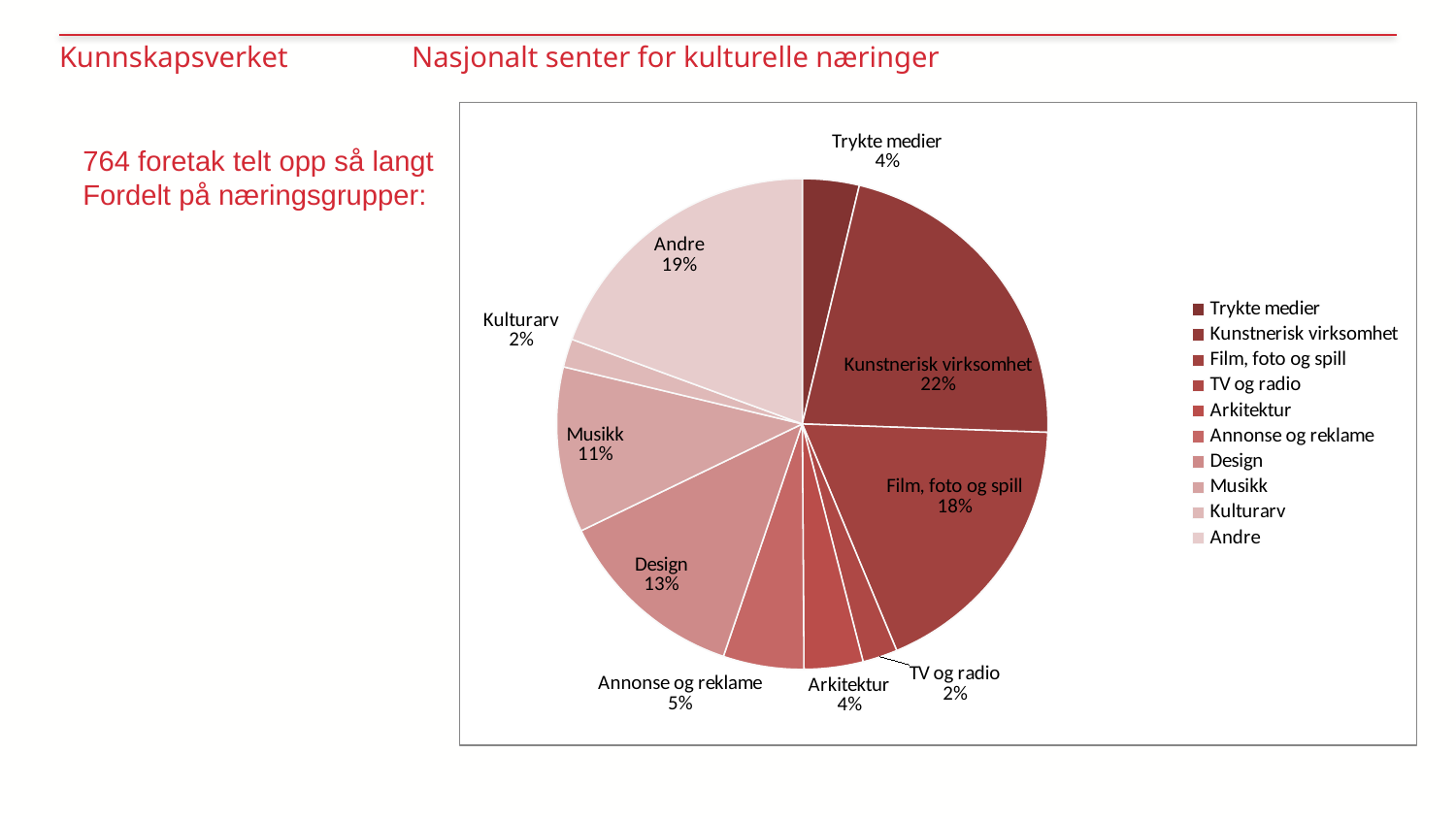
Which category has the largest slice of the pie? Kunstnerisk virksomhet What is the value shown for Film, foto og spill? 18% What is the difference in percentage points between Kunstnerisk virksomhet and Film, foto og spill? 4 percentage points What share of the pie does Andre have? 19% What share of the pie does Kunstnerisk virksomhet have? 22% What is the value shown for Musikk? 11% What is the value shown for Annonse og reklame? 5% How many categories does the pie chart show? 10 What kind of chart is shown on the slide? pie chart What is the value shown for Design? 13% Which is larger, the slice for Design or the slice for Musikk? Design How many entries does the legend list? 10